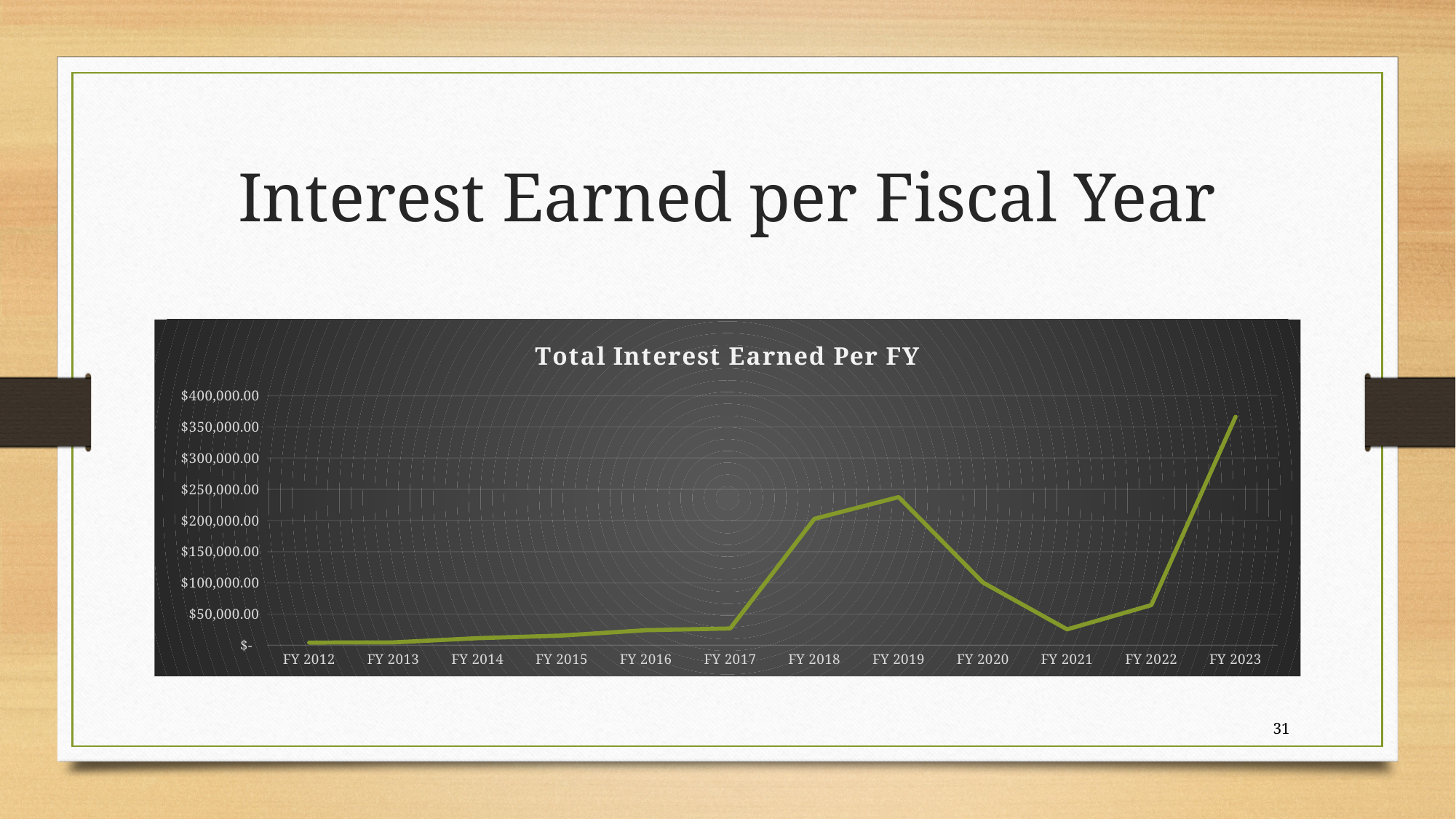
Is the value for FY 2021 greater or less than $50,000.00? less Which is larger, the value for FY 2022 or the value for FY 2021? FY 2022 Is the value for FY 2019 greater or less than $200,000.00? greater Does the line rise or fall from FY 2019 to FY 2021? fall Which fiscal year has the highest total interest earned? FY 2023 Which is larger, the value for FY 2019 or the value for FY 2020? FY 2019 Is the value for FY 2018 greater or less than $250,000.00? less What kind of chart is shown on the slide? line chart How many fiscal years are plotted on the x axis? 12 What is the title of the chart? Total Interest Earned Per FY